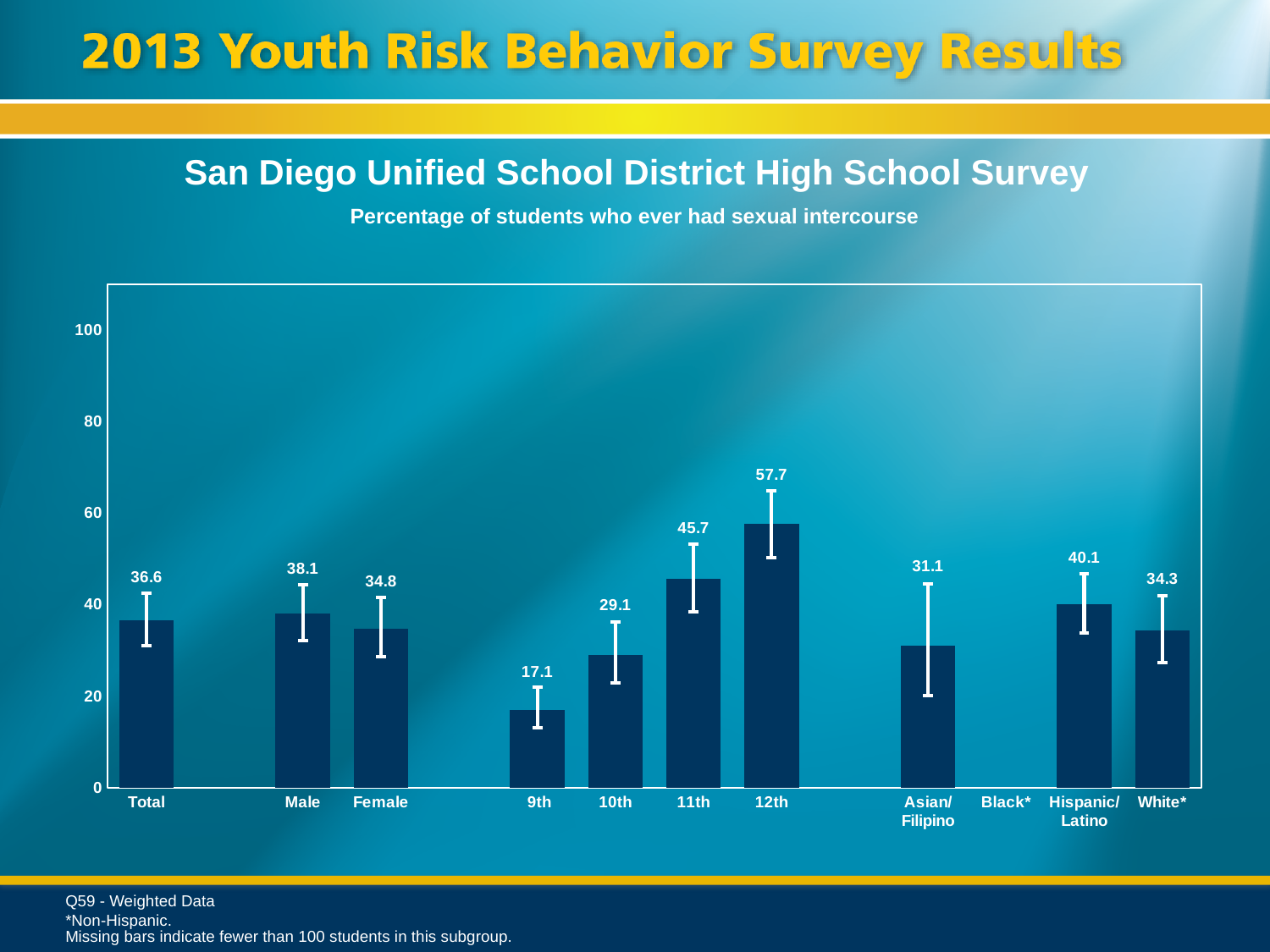
Is the value for 11th grade greater or less than 40? greater Which category has the highest value? 12th What is the value for 12th grade? 57.7 What is the value for Total? 36.6 What kind of chart is shown? bar chart What is the value for Asian/Filipino? 31.1 Which is larger, the value for Hispanic/Latino or the value for White*? Hispanic/Latino What is the difference between the Male and Female values? 3.3 Which category has the lowest plotted value? 9th How many categories have a bar plotted? 10 Which category has no bar plotted? Black* Do the values rise or fall from 9th grade to 12th grade? rise